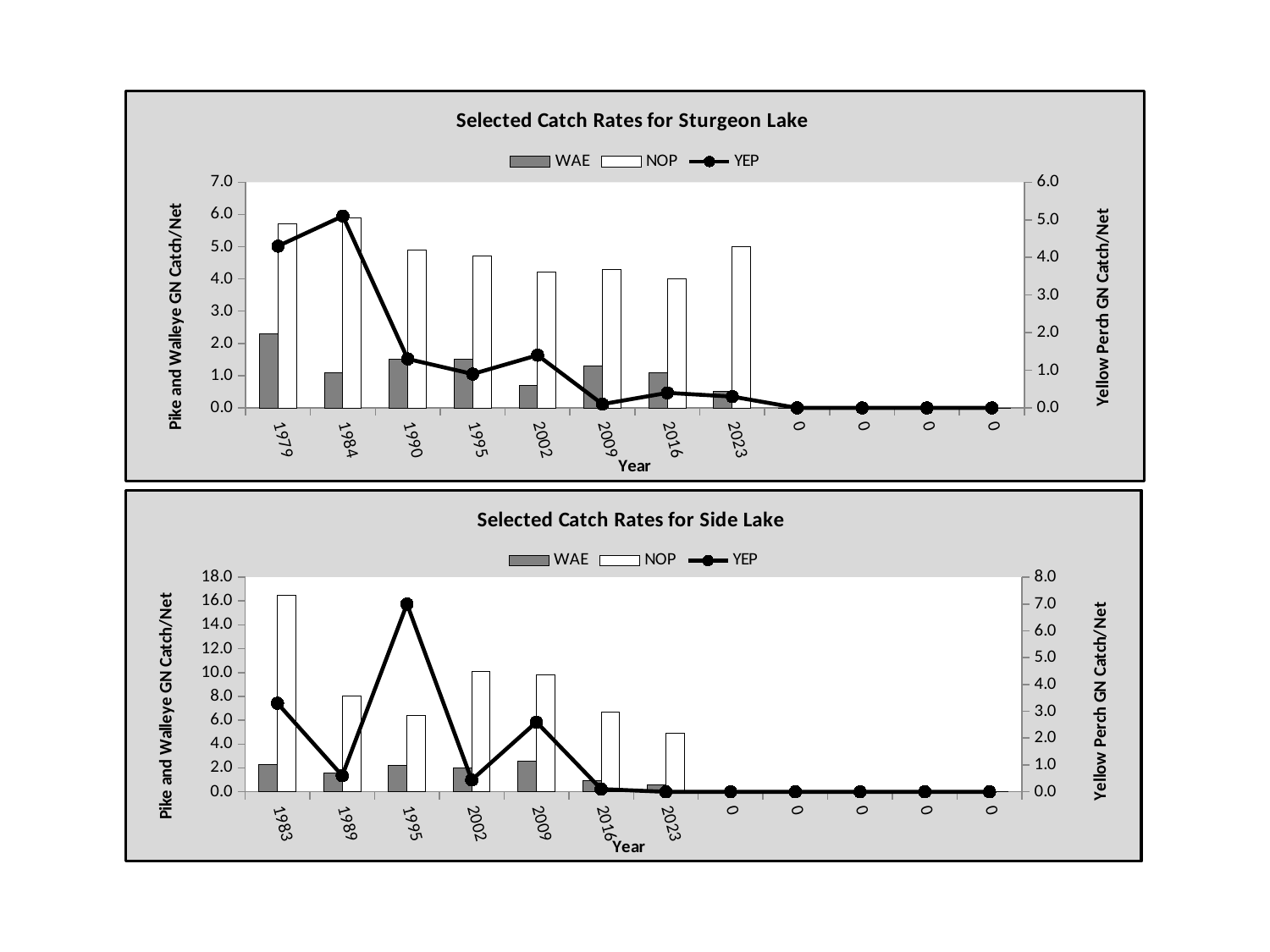
In the Selected Catch Rates for Sturgeon Lake chart, which year has the highest YEP value? 1984 In the Selected Catch Rates for Side Lake chart, which year has the highest YEP value? 1995 In the Selected Catch Rates for Sturgeon Lake chart, does the YEP line rise or fall from 1984 to 2009? fall In the Selected Catch Rates for Sturgeon Lake chart, how many labeled years are shown on the x axis? 8 In the Selected Catch Rates for Sturgeon Lake chart, how many series does the legend list? 3 In the Selected Catch Rates for Side Lake chart, what is the label of the right-hand vertical axis? Yellow Perch GN Catch/Net In the Selected Catch Rates for Sturgeon Lake chart, is the NOP value for 1979 greater or less than 5.0? greater In the Selected Catch Rates for Sturgeon Lake chart, which year has the highest WAE value? 1979 In the Selected Catch Rates for Side Lake chart, is the NOP value for 2023 greater or less than 6.0? less In the Selected Catch Rates for Sturgeon Lake chart, is the WAE value for 2002 greater or less than 1.0? less In the Selected Catch Rates for Sturgeon Lake chart, which is larger, the NOP value for 2016 or for 2023? 2023